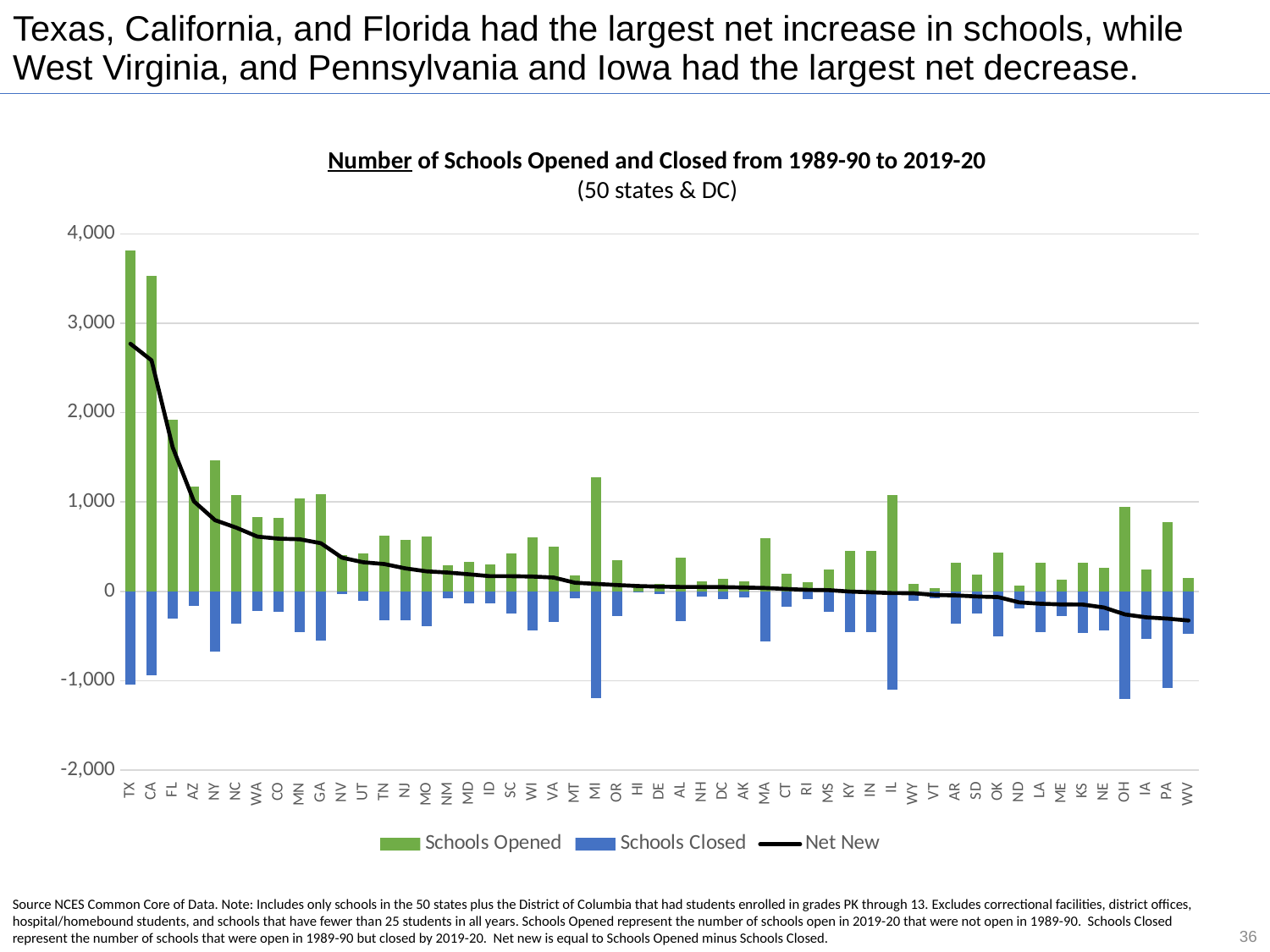
Is the Schools Opened value for MI greater or less than 1,000? greater Which state has the highest value for Schools Opened? TX Which has the larger Schools Opened value, MI or OR? MI Does the Net New line rise or fall moving from left to right along the x axis? fall Which state has the lowest Net New value? WV How many states/jurisdictions are shown along the x axis? 51 Is the Schools Closed value for CA greater or less than -500? less What kind of chart is shown on the slide? A bar chart with a line series How many series does the legend list? 3 Which colour represents Schools Closed in the legend? Blue Is the Schools Opened value for TX greater or less than 3,000? greater Which has the larger Schools Opened value, TX or CA? TX